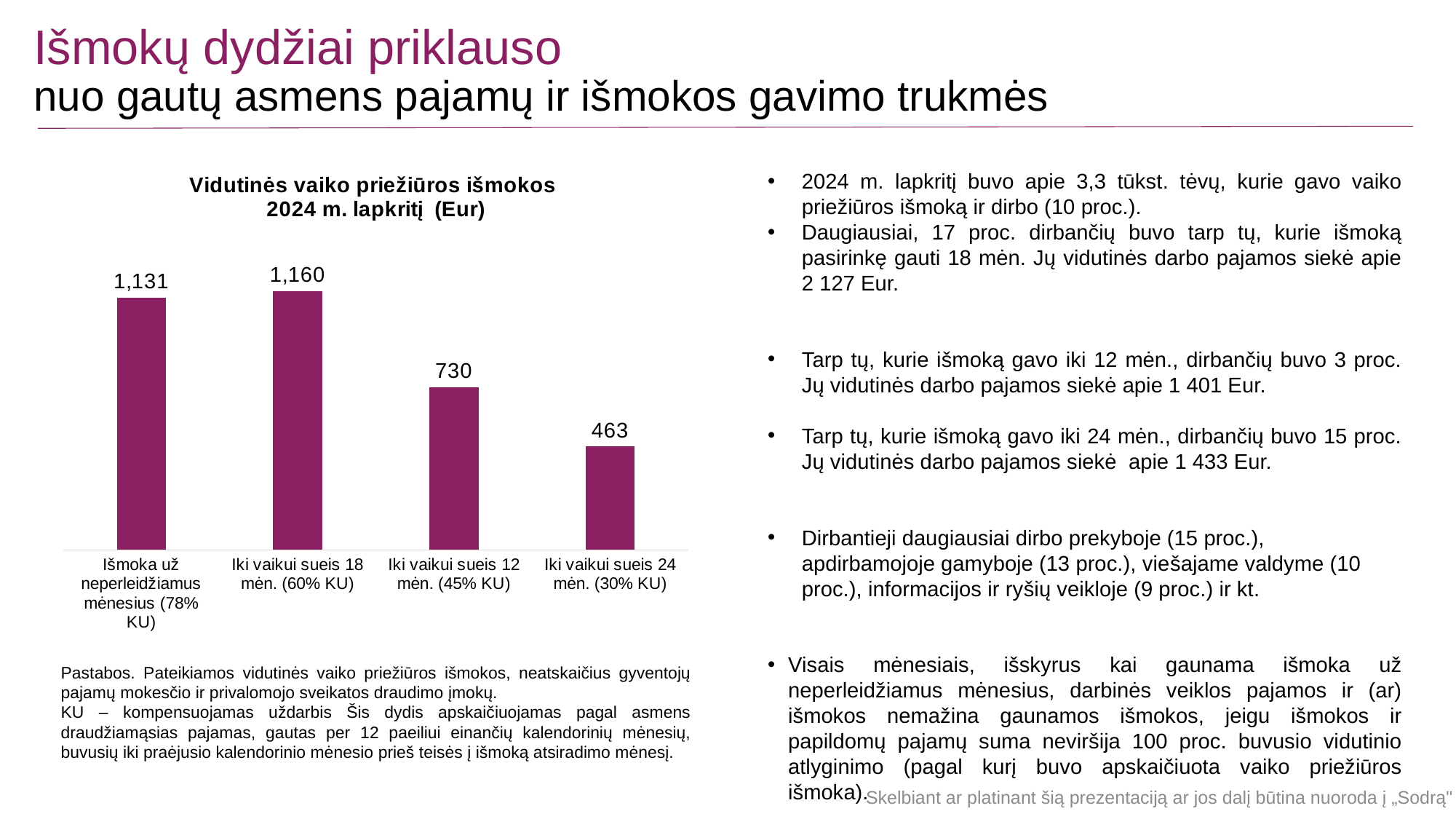
What is the value shown for 'Iki vaikui sueis 24 mėn. (30% KU)'? 463 What is the difference between the values for 'Iki vaikui sueis 18 mėn. (60% KU)' and 'Iki vaikui sueis 24 mėn. (30% KU)'? 697 What is the difference between the values for 'Iki vaikui sueis 12 mėn. (45% KU)' and 'Iki vaikui sueis 24 mėn. (30% KU)'? 267 Which category has the lowest average benefit? Iki vaikui sueis 24 mėn. (30% KU) What type of chart is shown on the slide? Bar chart How many categories are shown in the chart? 4 Which category has the highest average benefit? Iki vaikui sueis 18 mėn. (60% KU) What is the value shown for 'Iki vaikui sueis 12 mėn. (45% KU)'? 730 What is the average child care benefit for 'Iki vaikui sueis 18 mėn. (60% KU)'? 1,160 What is the title of the chart? Vidutinės vaiko priežiūros išmokos 2024 m. lapkritį (Eur) Which is larger: the value for 'Iki vaikui sueis 12 mėn. (45% KU)' or for 'Iki vaikui sueis 24 mėn. (30% KU)'? Iki vaikui sueis 12 mėn. (45% KU) What is the value shown for 'Išmoka už neperleidžiamus mėnesius (78% KU)'? 1,131